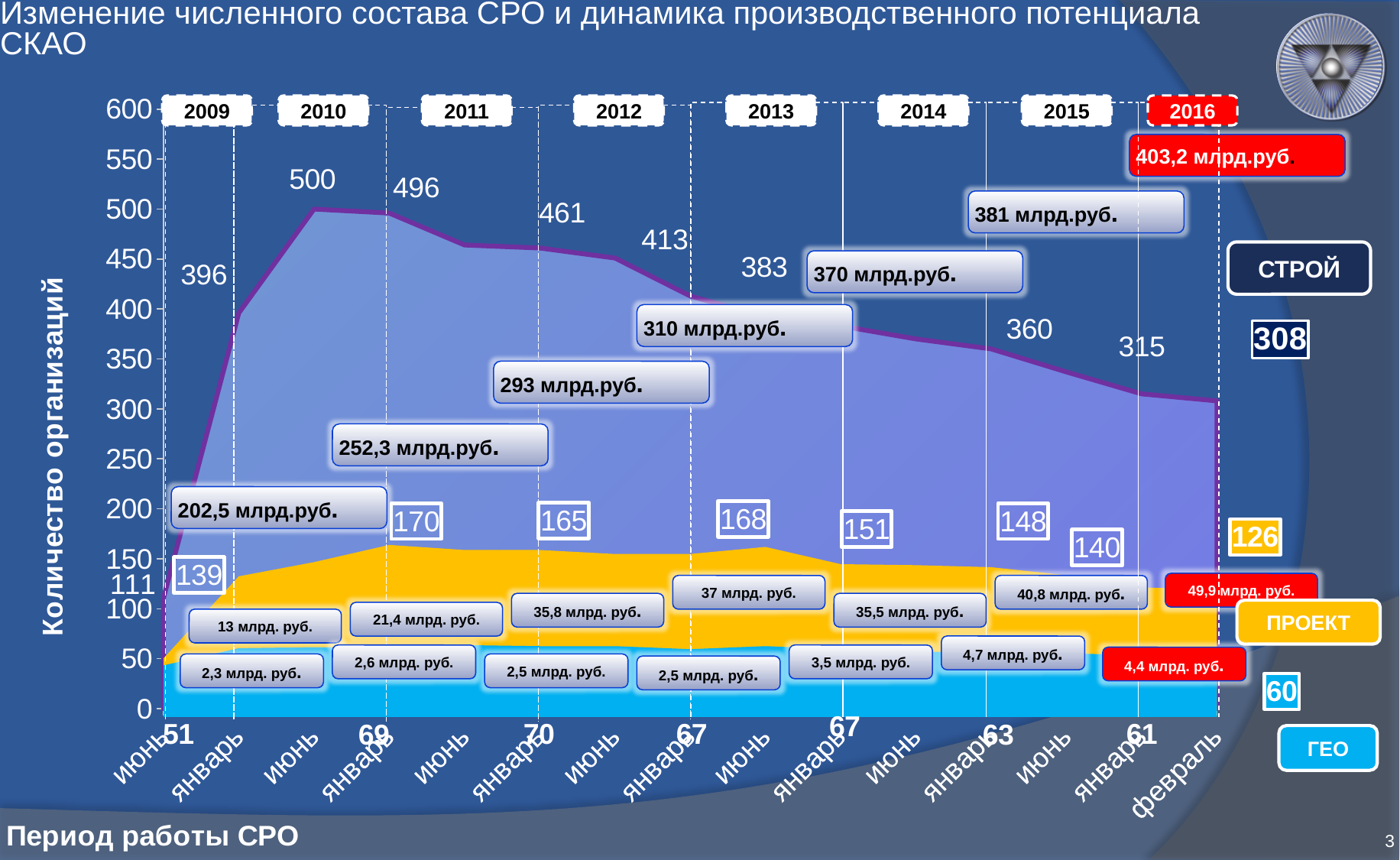
What production potential value is shown in the red box for 2016 for the СТРОЙ series? 403,2 млрд.руб. What is the labelled value of the СТРОЙ series for 2016? 308 What is the labelled value of the ГЕО series for 2016? 60 Which is larger: the first СТРОЙ value (396) or the СТРОЙ value labelled 315? 396 What kind of chart is shown on the slide? area chart Does the СТРОЙ series rise or fall from its peak of 500 to the 2016 value? fall What is the title of the vertical axis? Количество организаций What is the difference between the highest СТРОЙ value (500) and the 2016 СТРОЙ value (308)? 192 What production potential value is shown in the red box for the ГЕО series in 2016? 4,4 млрд. руб. How many year labels are shown along the top of the chart? 8 What is the labelled value of the ПРОЕКТ series for 2016? 126 What is the highest labelled value of the СТРОЙ (top) series? 500